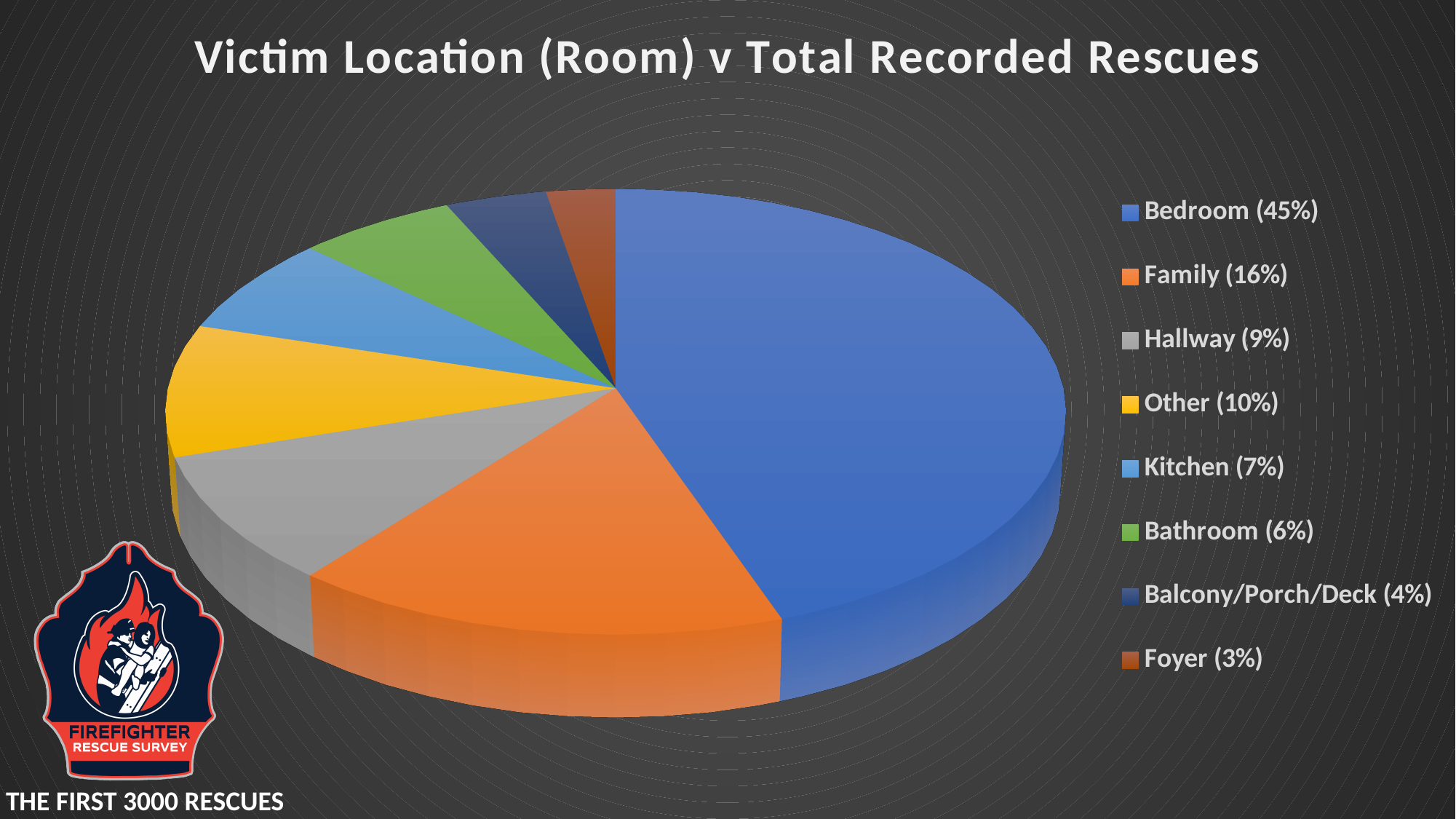
What is the title of the chart? Victim Location (Room) v Total Recorded Rescues Which room has the smallest share of recorded rescues? Foyer How many room categories does the pie chart show? 8 What type of chart is shown on the slide? Pie chart Which room has the largest share of recorded rescues? Bedroom What percentage is shown for Balcony/Porch/Deck? 4% What percentage is shown for Kitchen in the legend? 7% Which has a larger share, Hallway or Other? Other What colour is the Other slice in the pie chart? Yellow What is the combined share of Bathroom and Foyer? 9% What share of total recorded rescues does the Bedroom slice represent? 45% What is the difference in percentage points between Bedroom and Family? 29